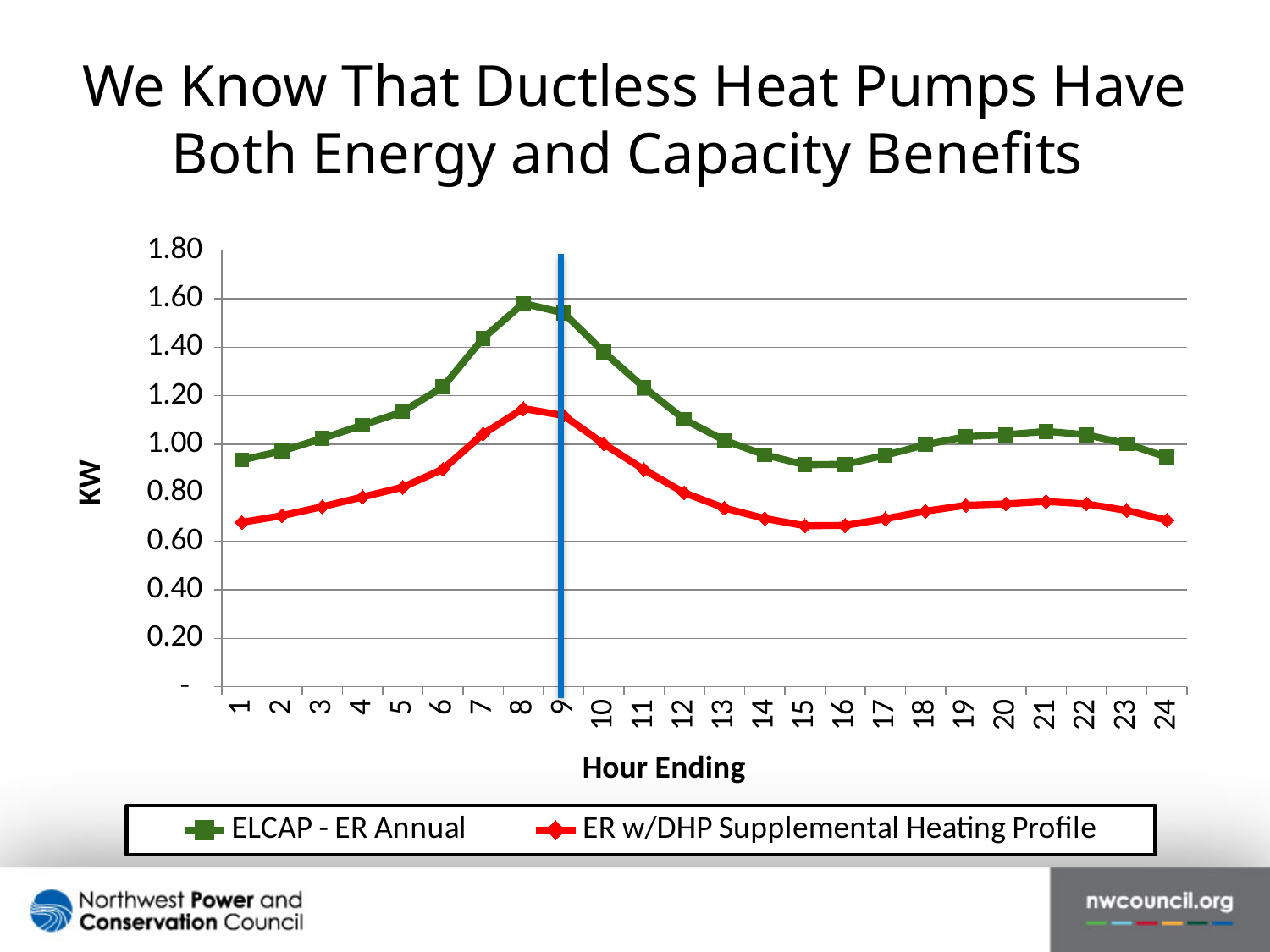
What kind of chart is shown on the slide? line chart At which hour ending does the ELCAP - ER Annual series reach its highest value? 8 Is the value for ER w/DHP Supplemental Heating Profile at hour ending 8 greater or less than 1.00? greater What is the label on the y axis? KW Is the value for ELCAP - ER Annual at hour ending 8 greater or less than 1.40? greater How many series does the legend list? 2 At hour ending 8, which series has the higher value, ELCAP - ER Annual or ER w/DHP Supplemental Heating Profile? ELCAP - ER Annual At which hour ending does the ER w/DHP Supplemental Heating Profile series reach its highest value? 8 Is the value for ER w/DHP Supplemental Heating Profile at hour ending 15 greater or less than 0.80? less What is the label on the x axis? Hour Ending Does the ELCAP - ER Annual series rise or fall from hour ending 8 to hour ending 15? fall How many hours are plotted along the x axis? 24